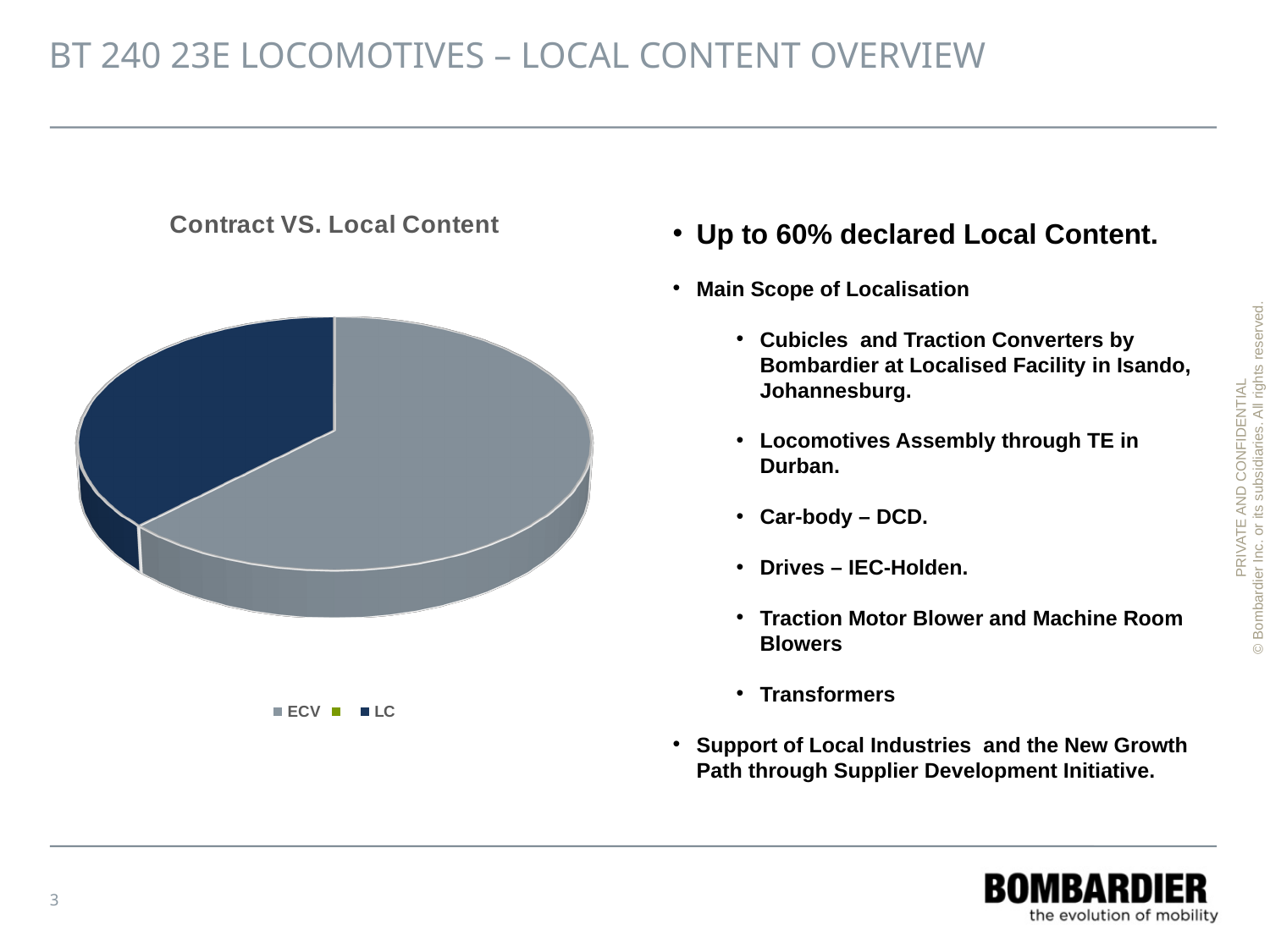
What kind of chart is shown on the slide? Pie chart Which labelled category has the smallest visible slice in the pie chart? LC Which category has the largest slice in the pie chart? ECV What colour is the LC slice in the pie chart? Dark blue What is the title of the chart? Contract VS. Local Content How many slices are visible in the pie chart? 2 Which slice is larger, ECV or LC? ECV